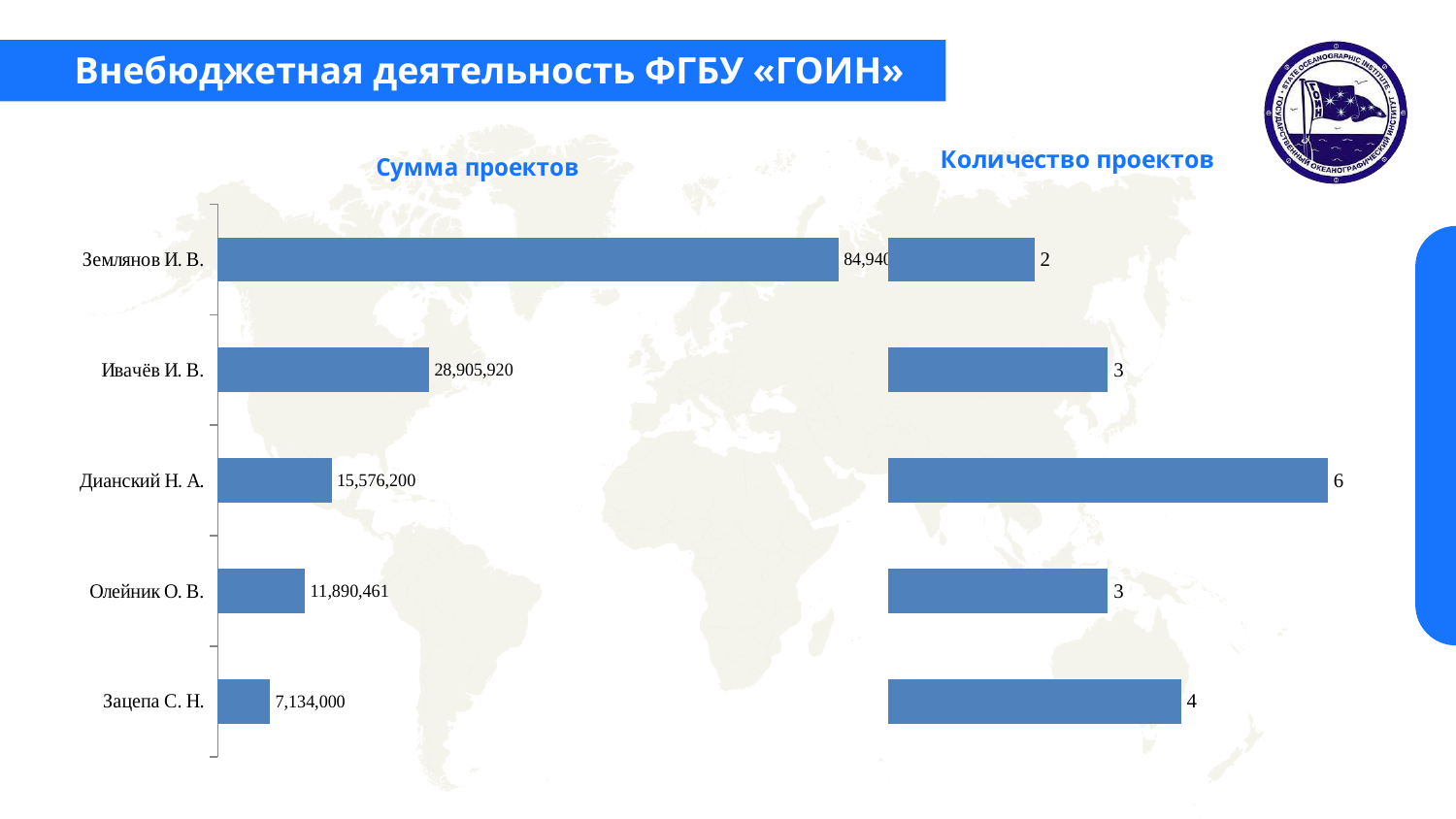
In the 'Сумма проектов' chart, which person has the highest value? Землянов И. В. How many people are listed in the 'Сумма проектов' chart? 5 In the 'Количество проектов' chart, who has the highest number of projects? Дианский Н. А. In the 'Сумма проектов' chart, what is the difference between the values for Дианский Н. А. and Олейник О. В.? 3,685,739 In the 'Количество проектов' chart, what is the value for Дианский Н. А.? 6 In the 'Сумма проектов' chart, what is the value for Зацепа С. Н.? 7,134,000 In the 'Количество проектов' chart, who has more projects, Зацепа С. Н. or Ивачёв И. В.? Зацепа С. Н. In the 'Сумма проектов' chart, which person has the lowest value? Зацепа С. Н. What type of chart is the 'Количество проектов' chart? Bar chart In the 'Количество проектов' chart, who has the lowest number of projects? Землянов И. В. In the 'Сумма проектов' chart, what is the value for Ивачёв И. В.? 28,905,920 In the 'Количество проектов' chart, what is the difference between the values for Дианский Н. А. and Землянов И. В.? 4